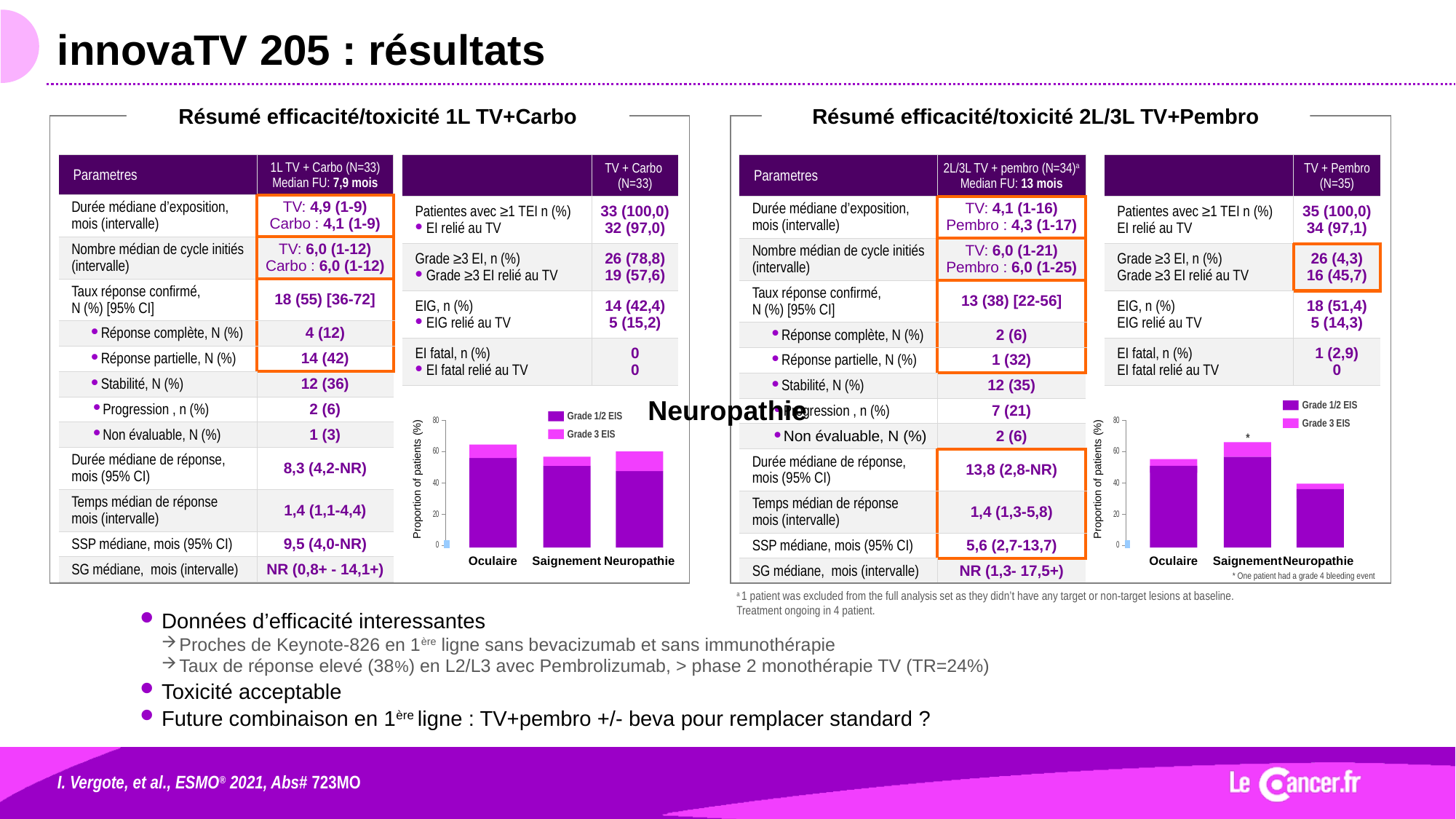
In the chart of the 'Résumé efficacité/toxicité 2L/3L TV+Pembro' panel, is the total bar for Saignement greater or less than 60? greater In the chart of the 'Résumé efficacité/toxicité 2L/3L TV+Pembro' panel, is the total bar for Neuropathie greater or less than 60? less In the chart of the 'Résumé efficacité/toxicité 1L TV+Carbo' panel, which total bar is larger, Oculaire or Saignement? Oculaire How many categories are plotted on the x axis of the chart in the 'Résumé efficacité/toxicité 2L/3L TV+Pembro' panel? 3 In the chart of the 'Résumé efficacité/toxicité 2L/3L TV+Pembro' panel, which category has the lowest total bar? Neuropathie What is the y-axis label of the chart in the 'Résumé efficacité/toxicité 2L/3L TV+Pembro' panel? Proportion of patients (%) In the chart of the 'Résumé efficacité/toxicité 1L TV+Carbo' panel, is the total bar for Oculaire greater or less than 60? greater What kind of chart is shown in the 'Résumé efficacité/toxicité 1L TV+Carbo' panel? Stacked bar chart How many series does the legend list in the chart of the 'Résumé efficacité/toxicité 1L TV+Carbo' panel? 2 What are the two legend entries of the chart in the 'Résumé efficacité/toxicité 2L/3L TV+Pembro' panel? Grade 1/2 EIS and Grade 3 EIS In the chart of the 'Résumé efficacité/toxicité 2L/3L TV+Pembro' panel, which category has the highest total bar? Saignement